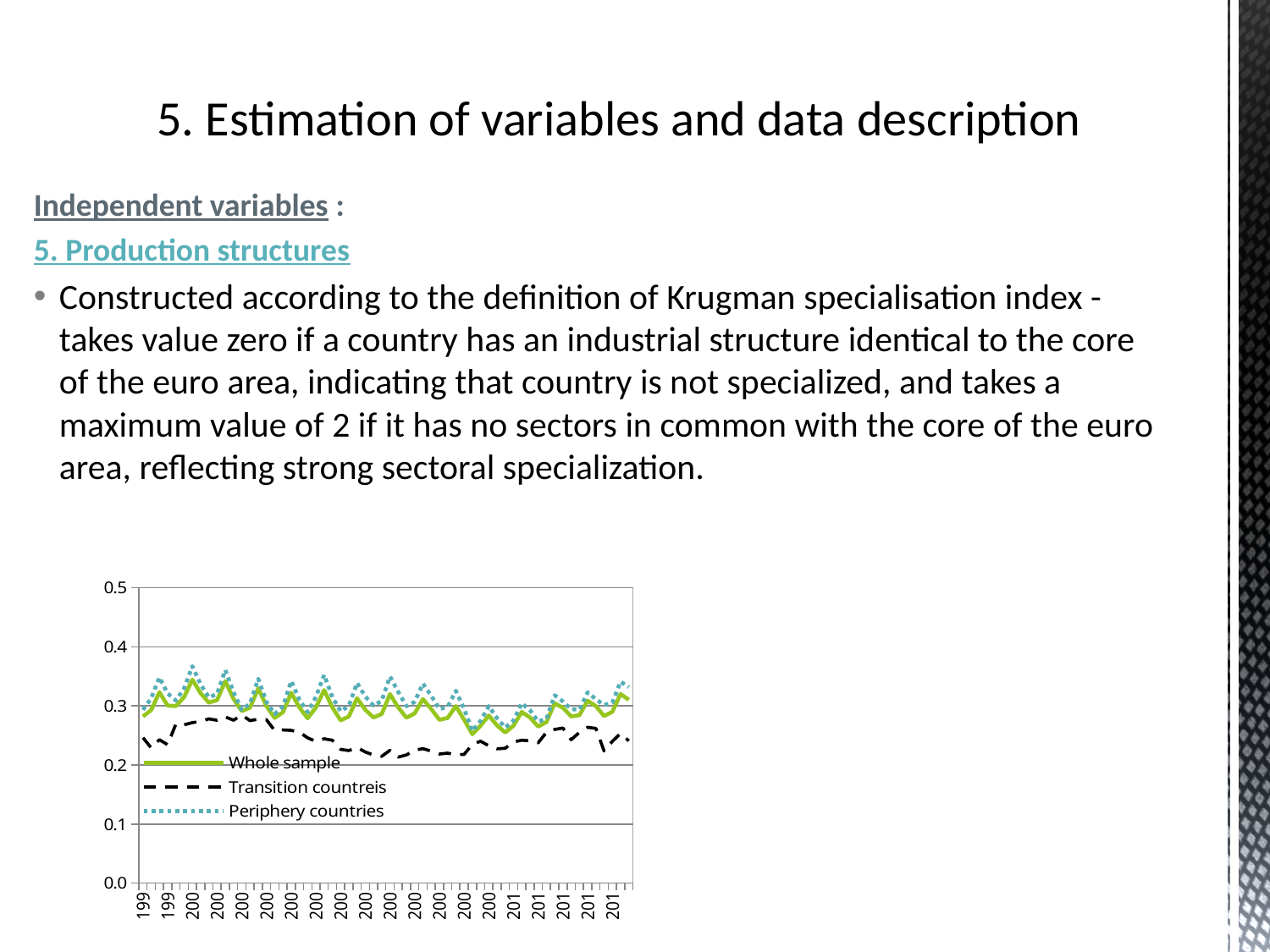
Are the values for Periphery countries greater or less than 0.2 across the chart? greater How many series does the chart's legend list? 3 Which series has larger values, Whole sample or Transition countreis? Whole sample Are the values for Transition countreis greater or less than 0.3 across the chart? less What is the maximum value shown on the chart's vertical axis? 0.5 Which series in the chart is drawn with a dashed black line? Transition countreis Which series has larger values, Periphery countries or Transition countreis? Periphery countries Which series has the lowest values throughout the chart? Transition countreis What kind of chart is shown on the slide? line chart Which series in the chart is drawn with a dotted line? Periphery countries Which series has the highest values throughout the chart? Periphery countries